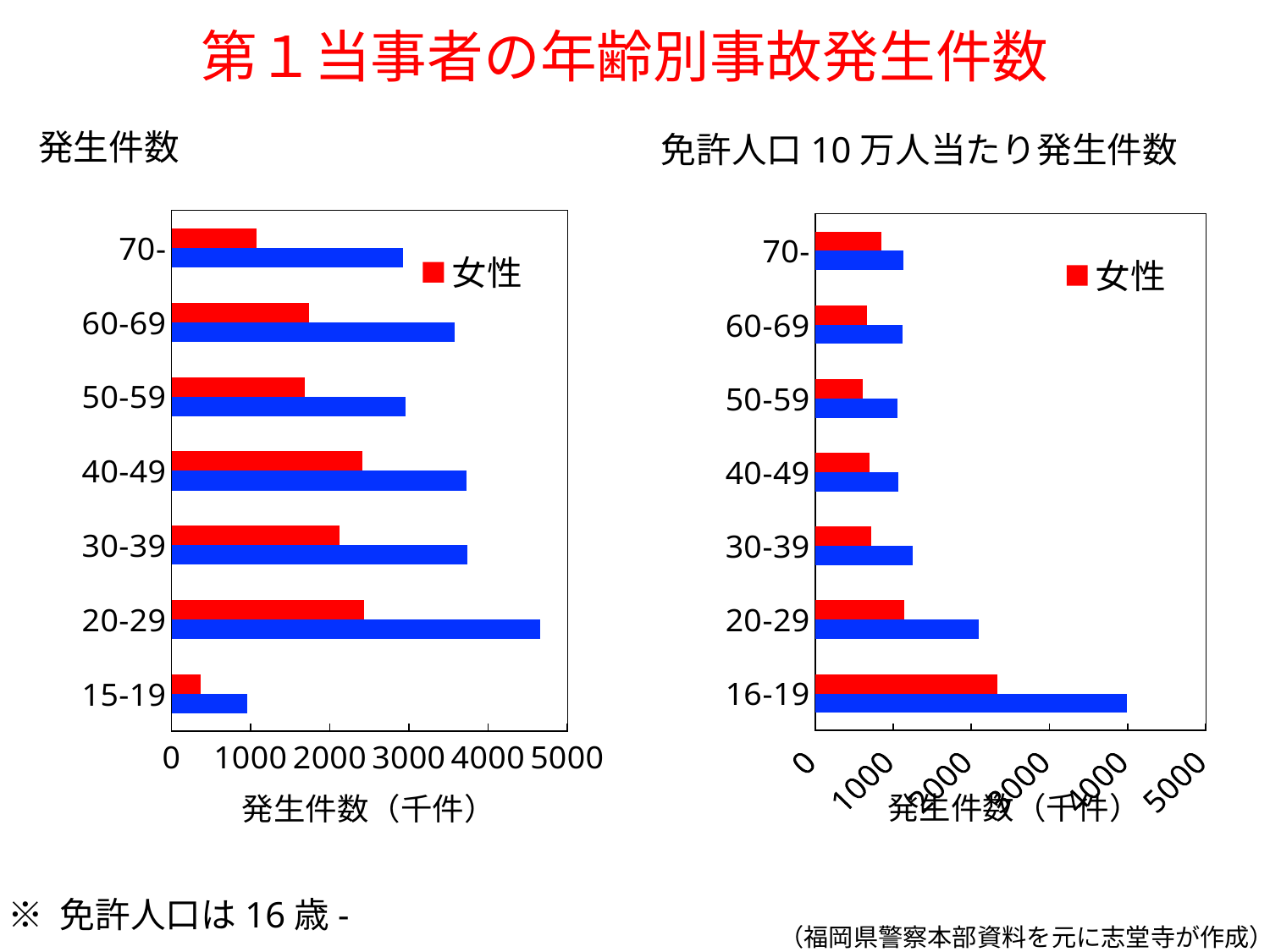
On the left chart (発生件数), which age category has the longest blue bar? 20-29 On the right chart (免許人口10万人当たり発生件数), which age category has the longest blue bar? 16-19 On the left chart (発生件数), is the red (女性) bar for 40-49 greater or less than 2000? greater What kind of chart is the left chart titled 発生件数? bar chart On the right chart (免許人口10万人当たり発生件数), is the red (女性) bar for 50-59 greater or less than 1000? less On the left chart (発生件数), is the blue bar for 60-69 greater or less than 3000? greater How many series does the legend of the right chart (免許人口10万人当たり発生件数) list? 1 On the left chart (発生件数), which age category has the shortest red (女性) bar? 15-19 How many age categories are shown on the left chart (発生件数)? 7 What series name does the legend on the left chart show for the red bars? 女性